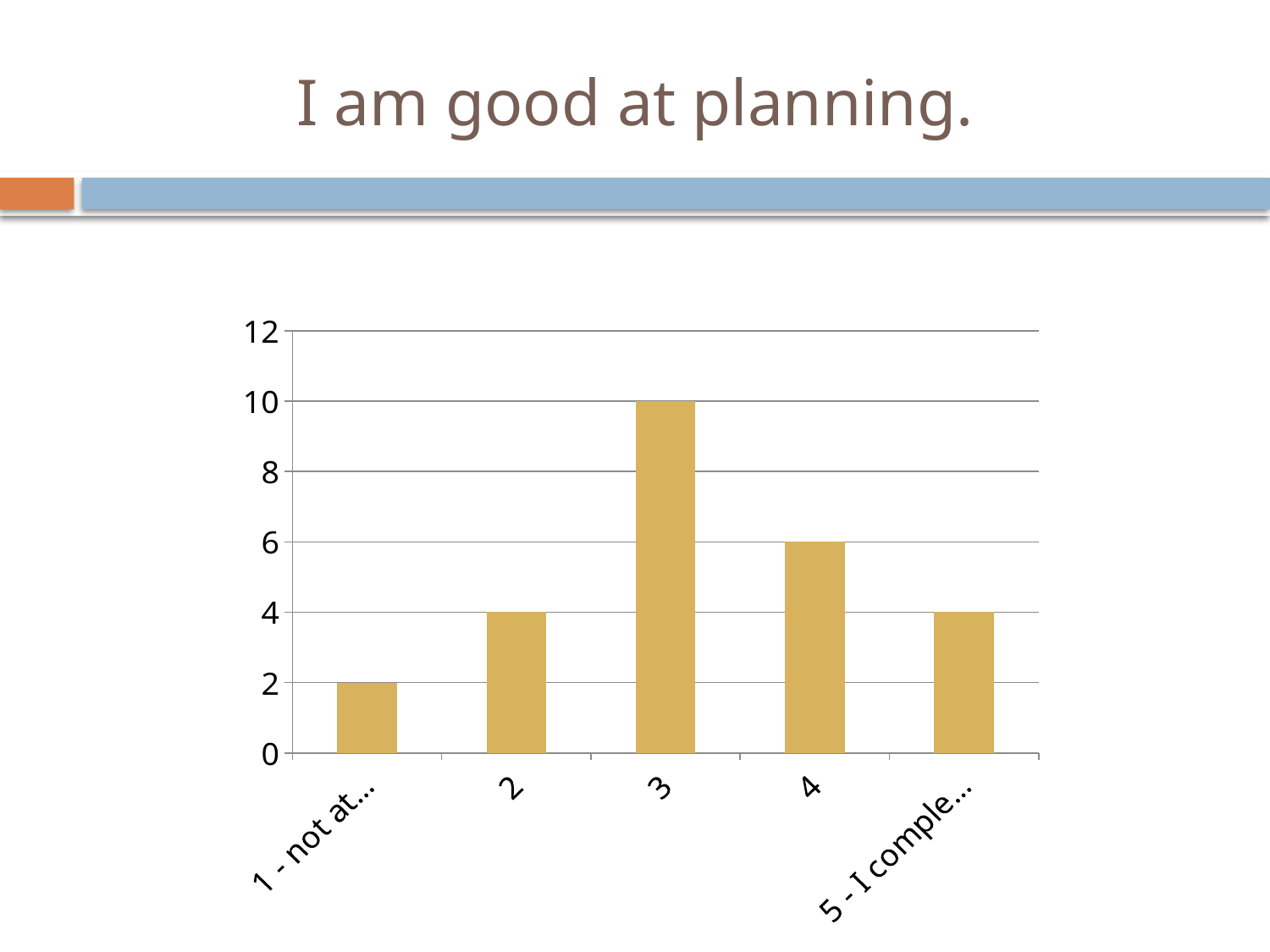
What is the value of the first bar (category 1 - not at...)? 2 What is the value of the bar for category 4? 6 What is the title of the slide containing the chart? I am good at planning. What is the value of the bar for category 3? 10 Is the value for category 3 greater or less than 8? greater How many bars (categories) are plotted in the chart? 5 Which category has the lowest bar? 1 - not at... What is the value of the bar for category 2? 4 Which is larger, the value for category 4 or the value for category 2? category 4 Which category has the highest bar? 3 What is the difference between the values for category 3 and category 4? 4 What type of chart is shown on the slide? bar chart